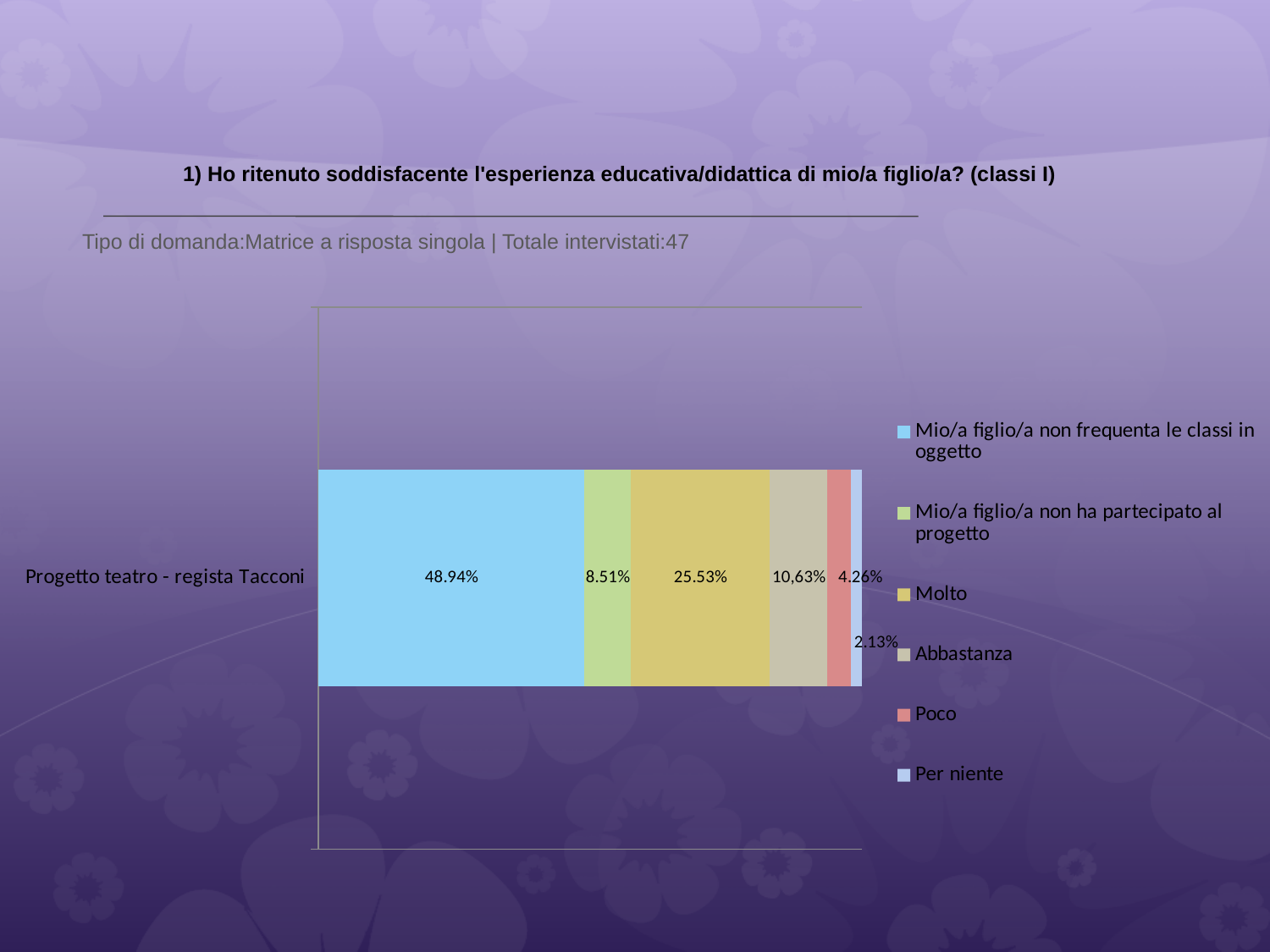
How many categories are plotted on the chart? 1 What is the value for "Molto" for Progetto teatro - regista Tacconi? 25.53% What is the value for "Mio/a figlio/a non ha partecipato al progetto"? 8.51% What is the value for "Abbastanza" for Progetto teatro - regista Tacconi? 10,63% Which is larger, the value for "Molto" or the value for "Abbastanza"? Molto What is the value for "Poco" for Progetto teatro - regista Tacconi? 4.26% What is the difference between the value for "Molto" and the value for "Poco"? 21.27% Which series has the highest value in the bar? Mio/a figlio/a non frequenta le classi in oggetto How many series does the legend list? 6 Which series has the lowest value in the bar? Per niente What is the value for "Per niente" for Progetto teatro - regista Tacconi? 2.13% What kind of chart is shown on the slide? stacked bar chart